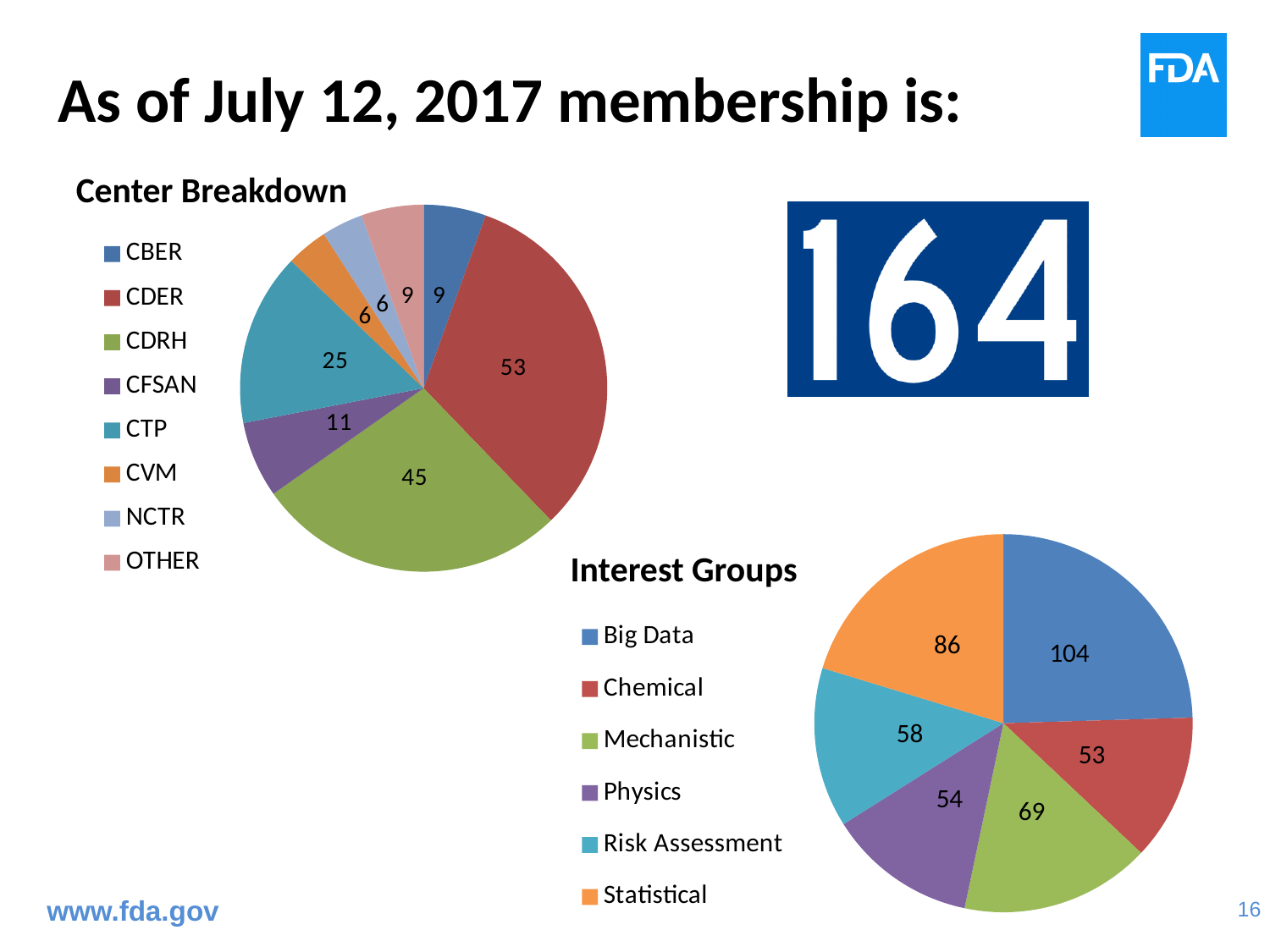
In the Center Breakdown chart, which center has the largest slice? CDER In the Center Breakdown chart, what is the total of all slices? 164 In the Center Breakdown chart, what is the difference between the CDRH and CFSAN values? 34 In the Interest Groups chart, which is larger, Mechanistic or Risk Assessment? Mechanistic In the Interest Groups chart, which interest group has the smallest slice? Chemical In the Interest Groups chart, what is the value for Statistical? 86 In the Interest Groups chart, what is the difference between Big Data and Physics? 50 In the Center Breakdown chart, what is the value for CTP? 25 In the Interest Groups chart, what colour is the Big Data slice? Blue In the Center Breakdown chart, how many categories does the legend list? 8 What type of chart is the Interest Groups chart? Pie chart In the Center Breakdown chart, what is the value for CDER? 53